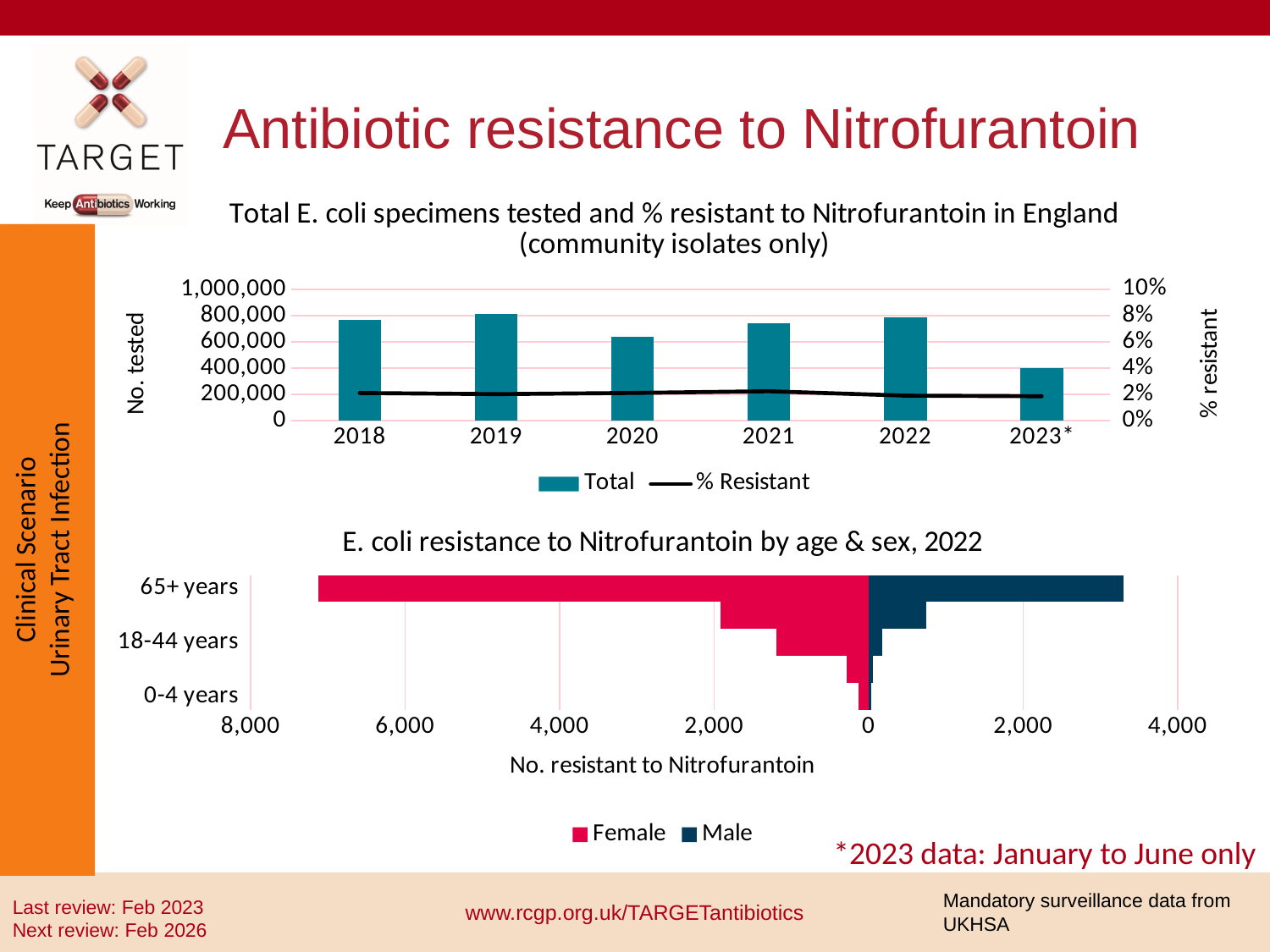
In the top chart, how many years are shown on the x axis? 6 In the bottom chart, 'E. coli resistance to Nitrofurantoin by age & sex, 2022', how many series does the legend list? 2 In the bottom chart, is the number of resistant Female isolates for 65+ years greater or less than 6,000? greater In the top chart, is the number tested in 2023* greater or less than 600,000? less In the bottom chart, which is larger for 65+ years, the Female or the Male number resistant? Female In the top chart, is the number tested in 2019 greater or less than 600,000? greater In the top chart, how many series does the legend list? 2 In the top chart, which year has the lowest number tested? 2023* In the top chart, which year has more specimens tested, 2020 or 2021? 2021 What does the asterisk on 2023 in the top chart indicate, according to the slide? 2023 data: January to June only What kind of chart is the top chart, 'Total E. coli specimens tested and % resistant to Nitrofurantoin in England'? Bar chart with a line